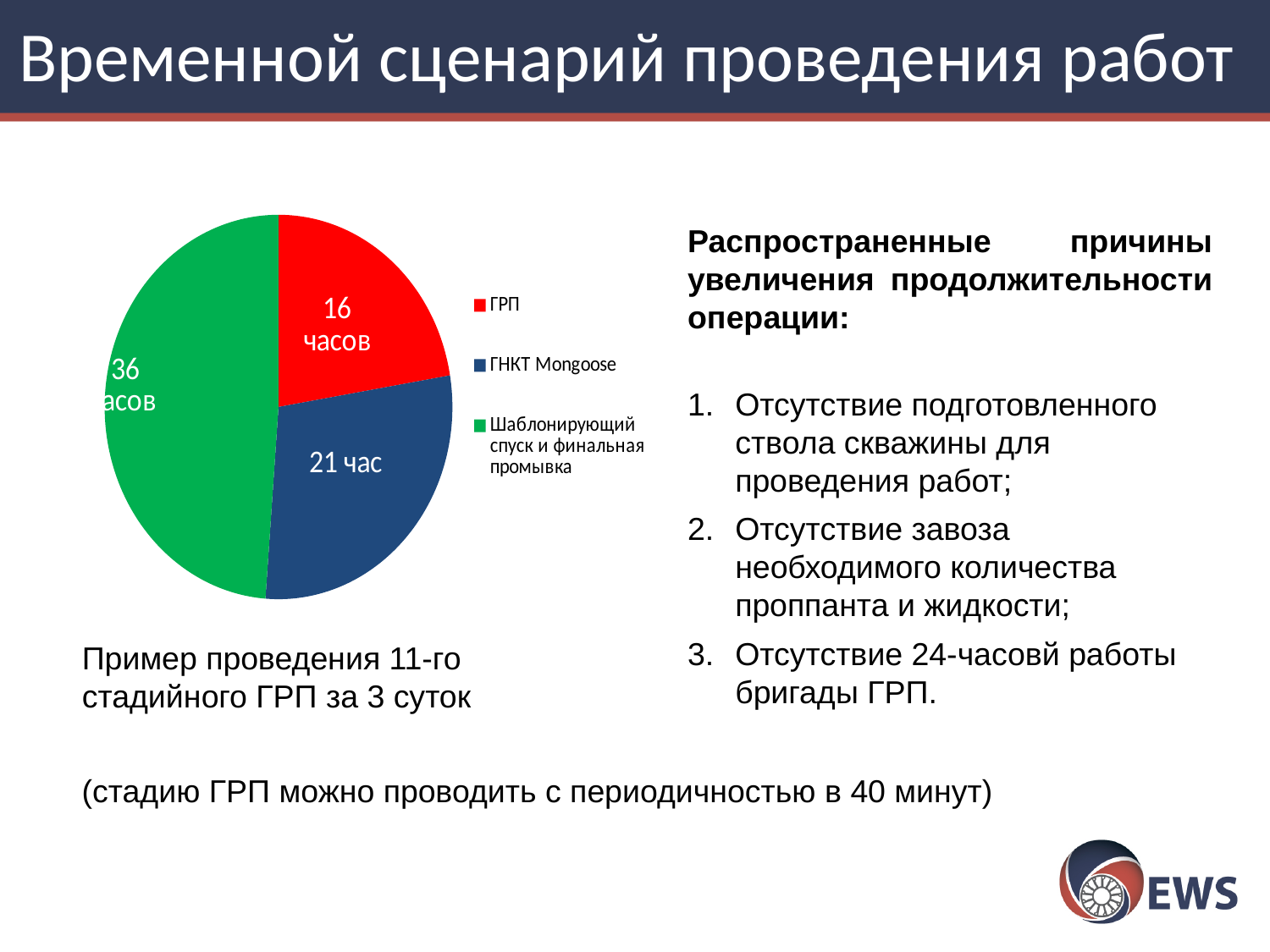
What colour is the ГРП slice in the pie chart? Red How many hours are shown for Шаблонирующий спуск и финальная промывка in the pie chart? 36 часов How many slices does the pie chart have? 3 How many more hours does ГНКТ Mongoose take than ГРП? 5 How many hours are shown for ГНКТ Mongoose in the pie chart? 21 час How many entries does the legend of the pie chart list? 3 Which category takes the fewest hours in the pie chart? ГРП How many more hours does Шаблонирующий спуск и финальная промывка take than ГНКТ Mongoose? 15 How many hours are shown for ГРП in the pie chart? 16 часов What kind of chart is shown on the slide? Pie chart Which takes more hours, ГРП or ГНКТ Mongoose? ГНКТ Mongoose Which category takes the most hours in the pie chart? Шаблонирующий спуск и финальная промывка